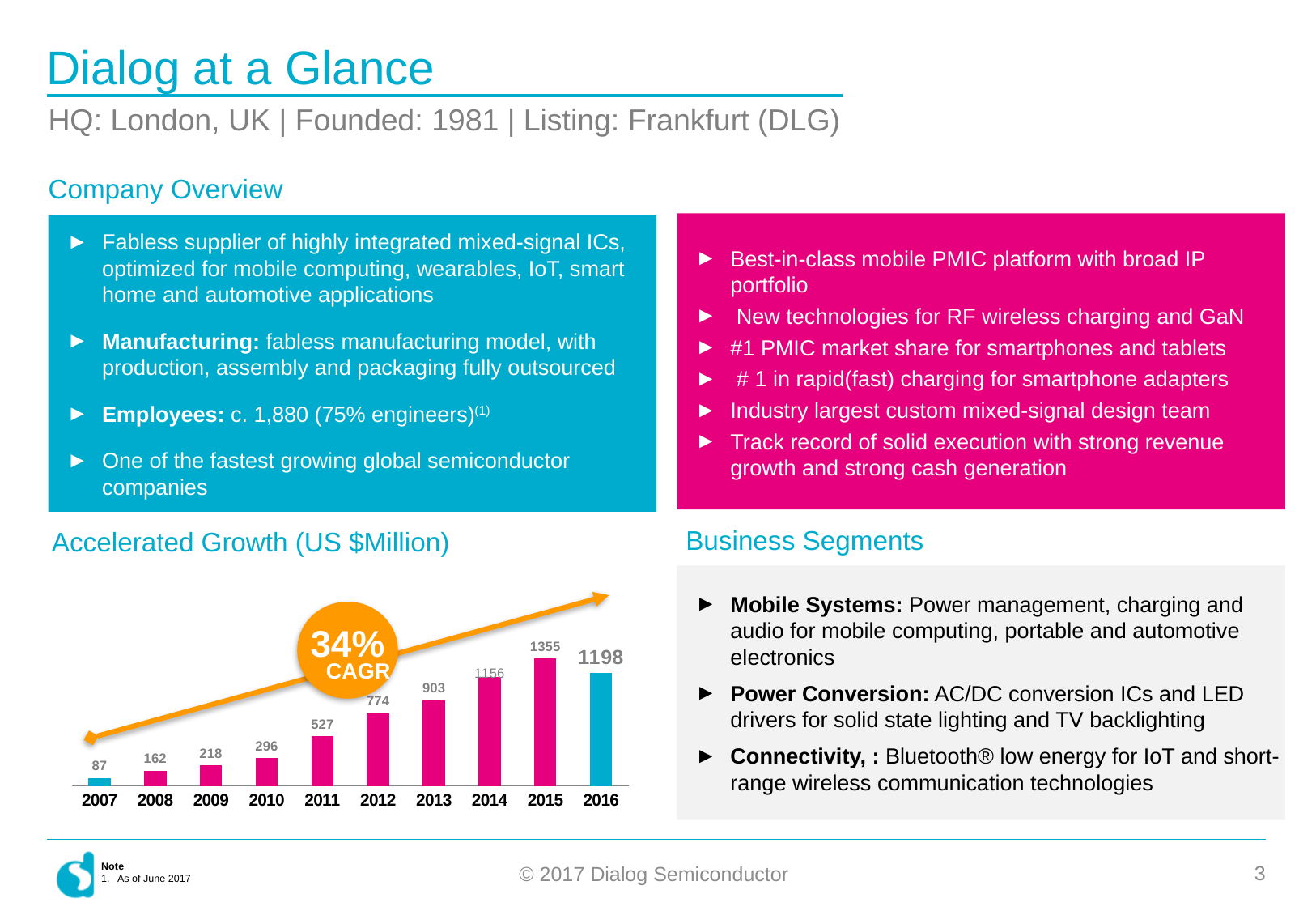
What is the value for 2007 in the Accelerated Growth chart? 87 What kind of chart is the Accelerated Growth chart? bar chart What CAGR is shown in the circle on the Accelerated Growth chart? 34% What is the difference between the 2011 and 2010 values in the Accelerated Growth chart? 231 What is the value for 2016 in the Accelerated Growth chart? 1198 What is the difference between the 2015 and 2016 values in the Accelerated Growth chart? 157 Do the values in the Accelerated Growth chart generally rise or fall from 2007 to 2015? rise Which year has the lowest value in the Accelerated Growth chart? 2007 Which is larger in the Accelerated Growth chart, the value for 2013 or the value for 2014? 2014 How many years are shown in the Accelerated Growth chart? 10 Which year has the highest value in the Accelerated Growth chart? 2015 What is the value for 2012 in the Accelerated Growth chart? 774